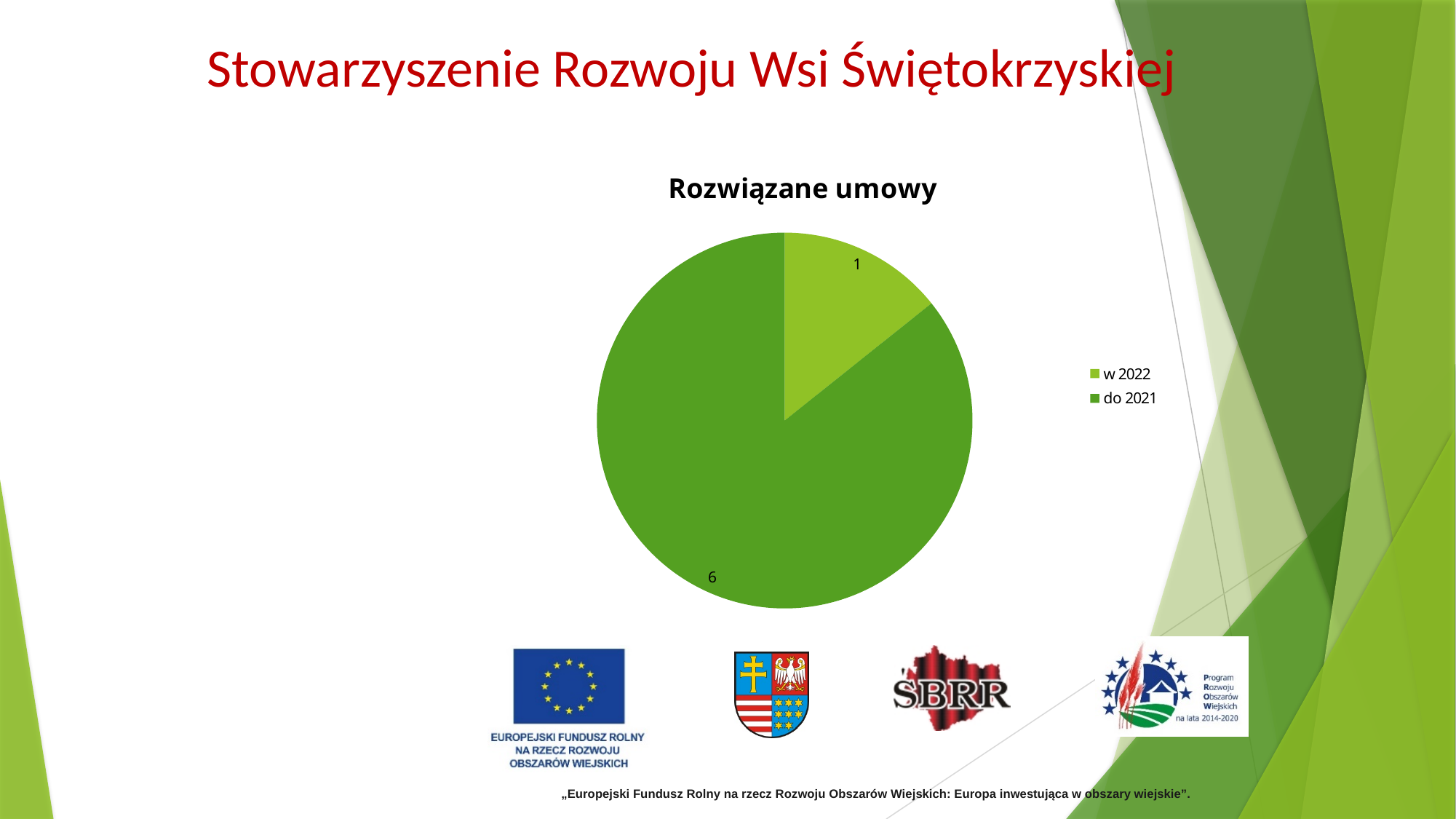
What is the value for "w 2022"? 1 What is the difference between the values for "do 2021" and "w 2022"? 5 What share of the pie does "do 2021" represent? 6/7 Which legend entry is shown in the lighter green colour? w 2022 Which category has the smallest slice of the pie? w 2022 How many categories does the legend list? 2 What is the total of all slices in the pie? 7 What type of chart is shown on the slide? pie chart What is the value for "do 2021"? 6 Which is larger, the value for "w 2022" or the value for "do 2021"? do 2021 What is the title of the chart? Rozwiązane umowy Which category has the largest slice of the pie? do 2021